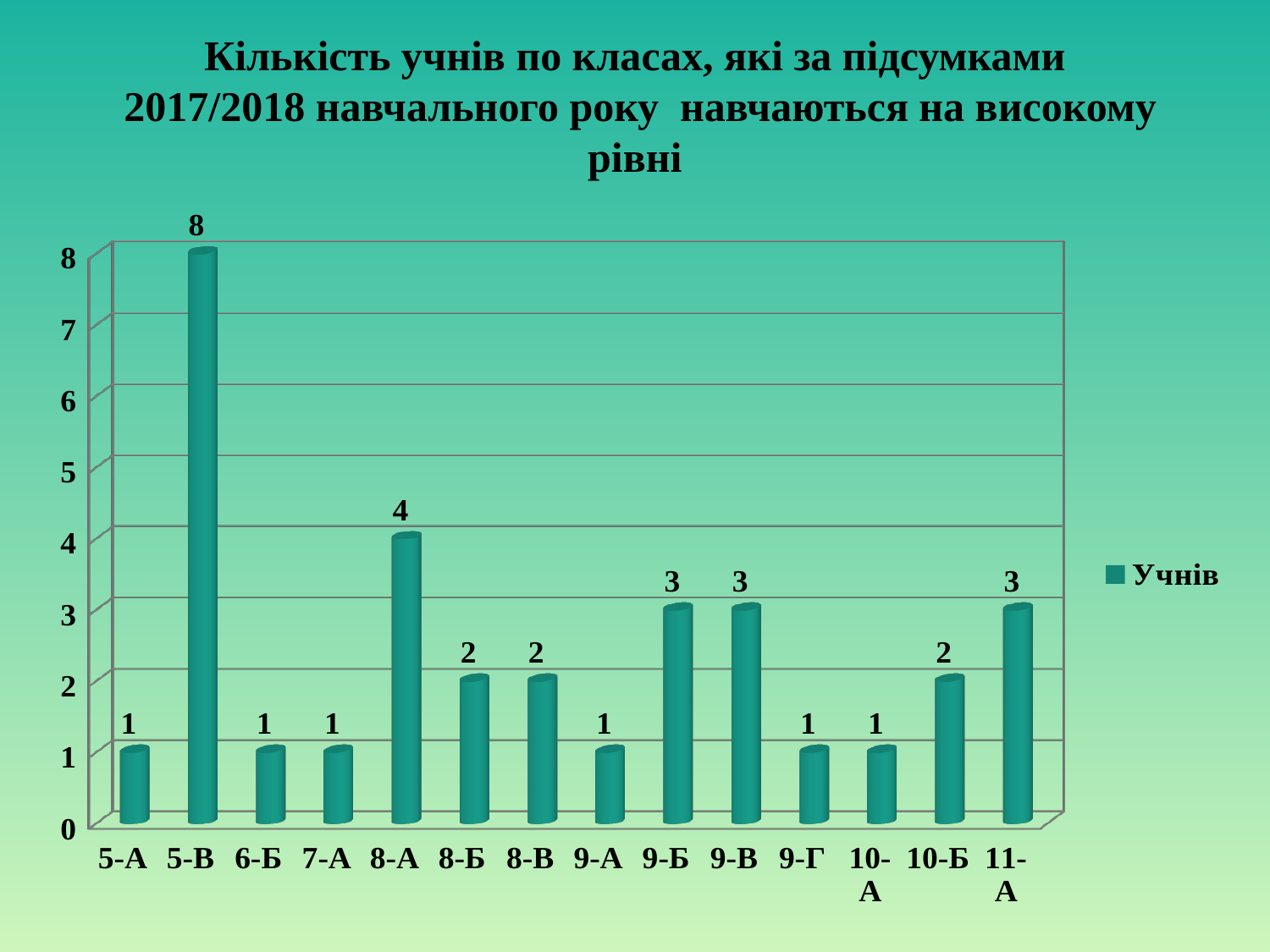
What is the value for 5-В? 8 What is the value for 10-Б? 2 What is the difference between the values for 5-В and 8-А? 4 What is the value for 8-А? 4 Is the value for 5-В greater or less than 6? greater How many series does the legend list? 1 What kind of chart is shown on the slide? bar chart Which class has the highest value? 5-В What is the difference between the values for 9-Б and 9-Г? 2 Which is larger, the value for 8-Б or the value for 9-В? 9-В What is the value for 11-А? 3 How many classes are shown on the x axis? 14